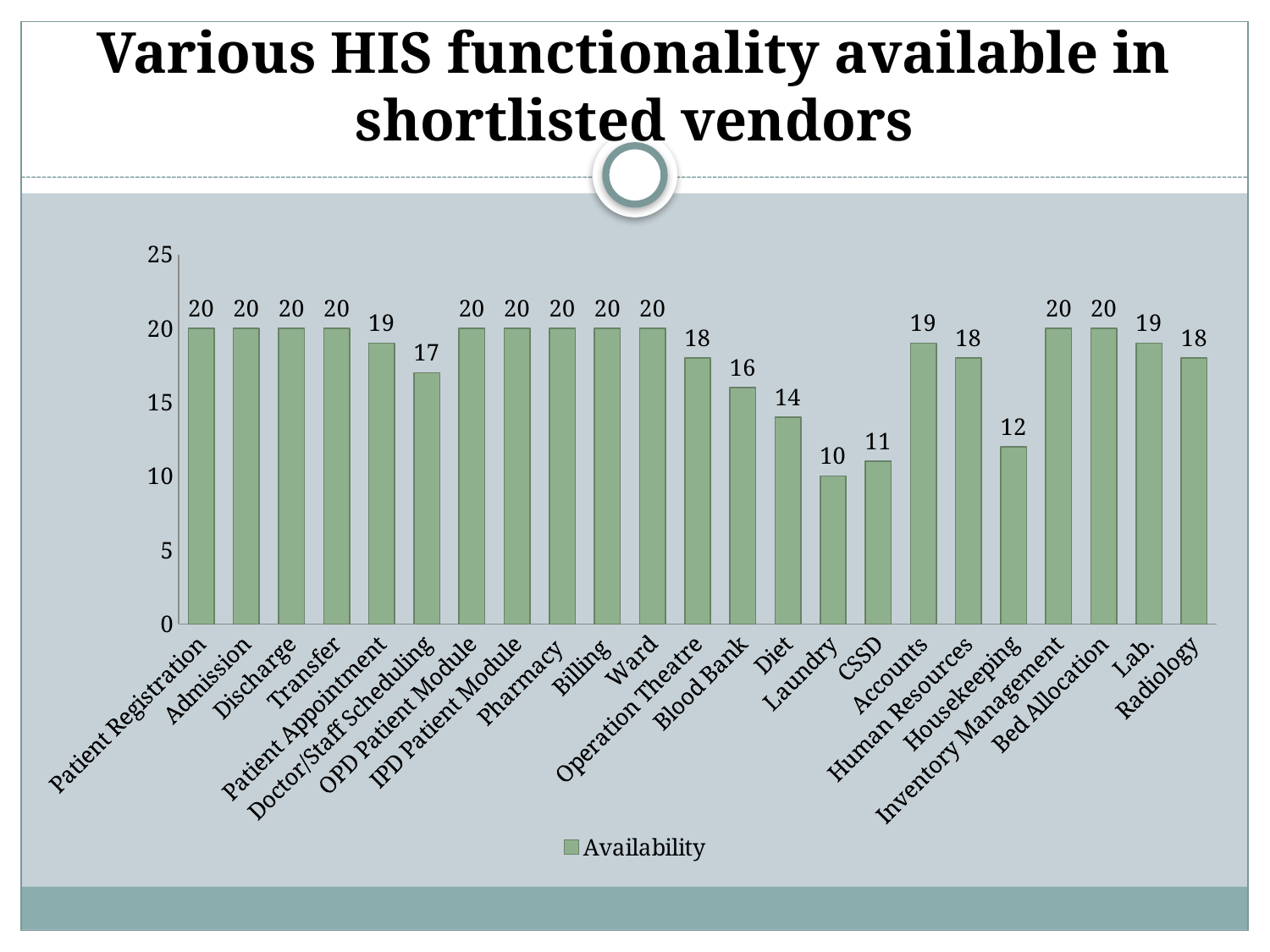
Which has a higher Availability value, Accounts or Human Resources? Accounts What is the Availability value for Blood Bank? 16 How many series does the legend list? 1 What is the difference between the Availability values for Diet and CSSD? 3 What is the difference between the Availability values for Patient Registration and Laundry? 10 Which has a higher Availability value, Housekeeping or Radiology? Radiology What is the Availability value for Doctor/Staff Scheduling? 17 What is the Availability value for Laundry? 10 What is the Availability value for Housekeeping? 12 What kind of chart is shown on the slide? Bar chart Which category has the lowest Availability value? Laundry How many categories are shown on the x axis of the chart? 23